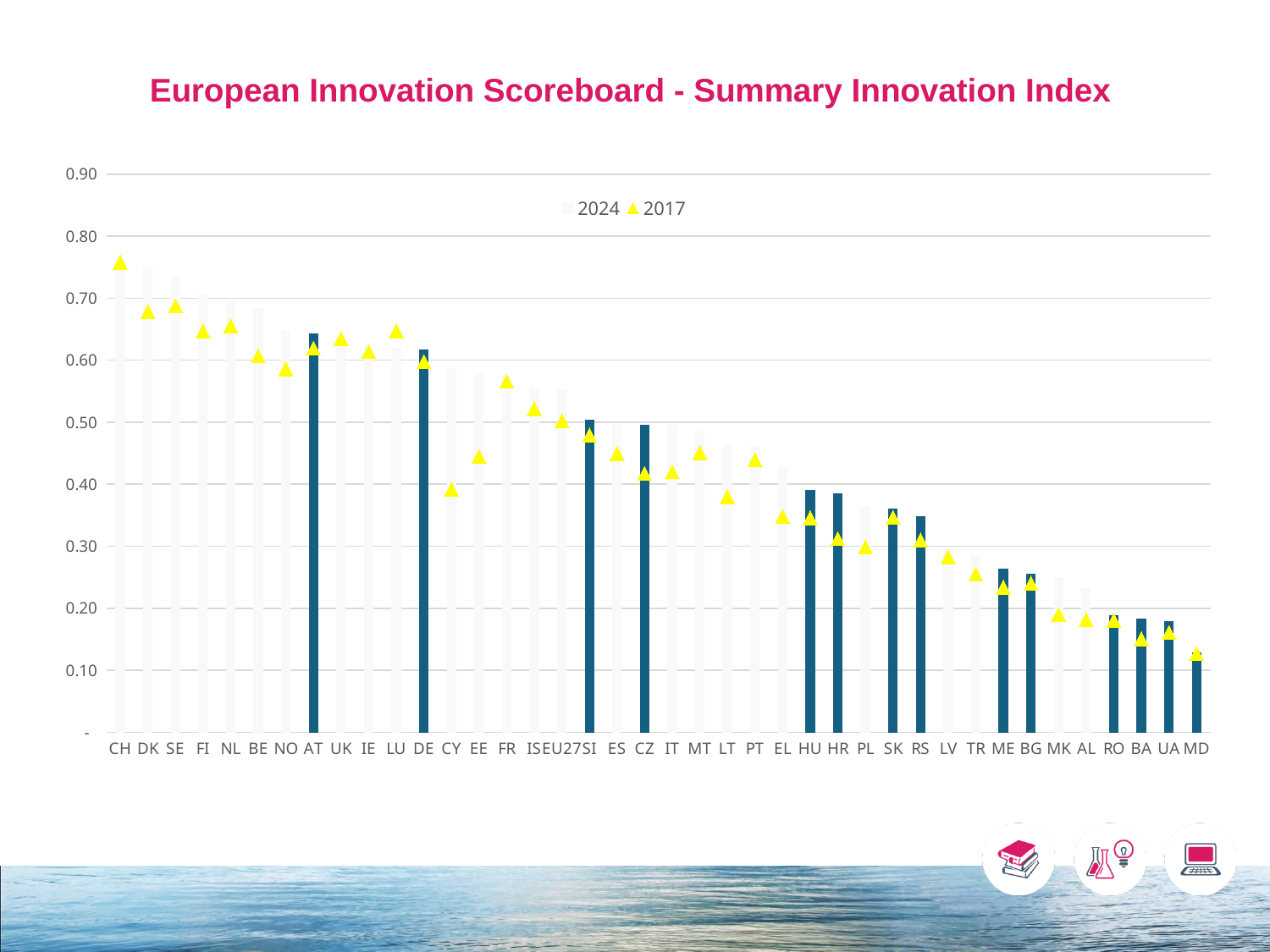
How many series does the legend list? 2 Which has the larger 2024 value, CZ or HU? CZ How many countries/regions are shown along the x axis? 40 Which series is plotted with yellow triangle markers? 2017 Which country has the highest 2024 value? CH What kind of chart is shown on the slide? Bar chart Do the 2024 values rise or fall moving from left to right along the x axis? Fall Which country has the lowest 2024 value? MD Is the 2017 value for CY greater or less than 0.50? less What is the title of the chart? European Innovation Scoreboard - Summary Innovation Index Is the 2024 value for CH greater or less than 0.70? greater Is the 2024 value for MD greater or less than 0.20? less